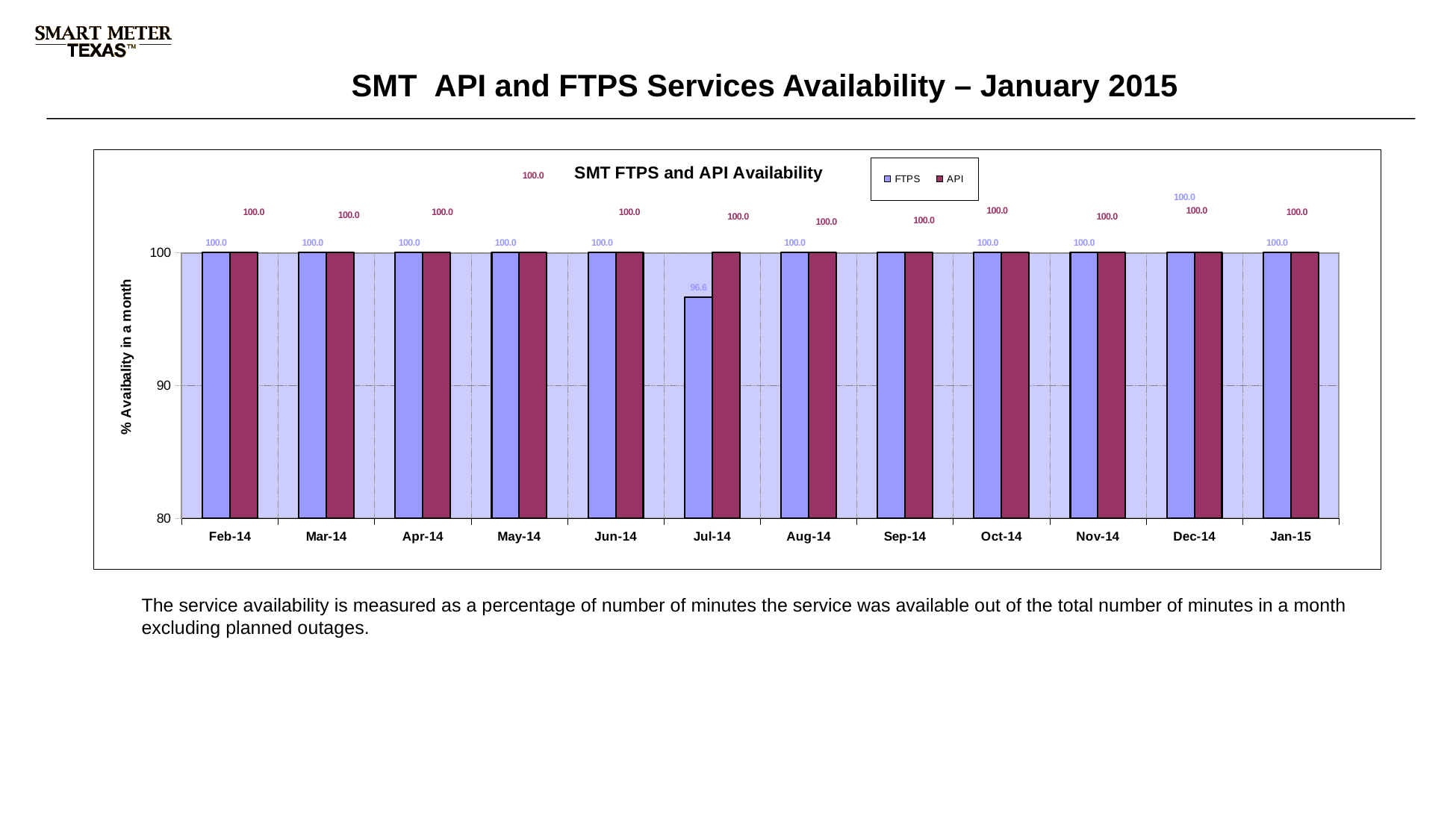
What is the FTPS availability value for Dec-14? 100.0 Is the FTPS value for Jul-14 greater or less than 90? greater What is the y-axis label of the chart? % Avaibality in a month What is the FTPS availability value for Jul-14? 96.6 For Jul-14, which is larger, the FTPS value or the API value? API What is the difference between the API and FTPS values for Jul-14? 3.4 What is the API availability value for Jul-14? 100.0 How many months are shown on the x axis? 12 What is the title of the chart? SMT FTPS and API Availability How many series does the legend list? 2 Which month has the lowest FTPS availability? Jul-14 What kind of chart is shown? Bar chart